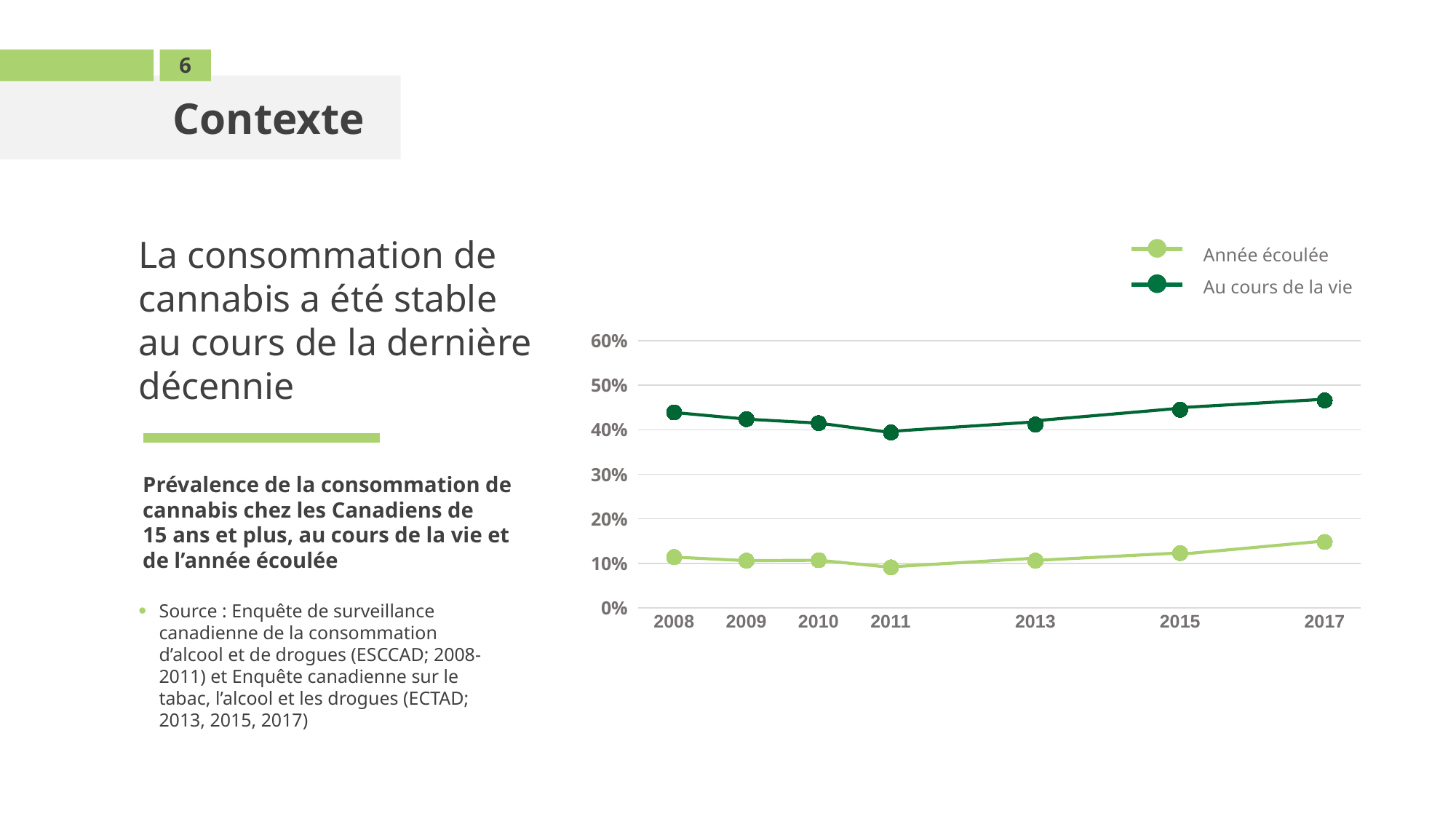
In which year is the 'Au cours de la vie' series at its highest? 2017 In which year is the 'Année écoulée' series at its highest? 2017 How many series does the legend list? 2 In which year is the 'Au cours de la vie' series at its lowest? 2011 In which year is the 'Année écoulée' series at its lowest? 2011 How many years are plotted along the x axis? 7 Does the 'Au cours de la vie' series rise or fall from 2011 to 2017? rise Which is larger for the 'Au cours de la vie' series: the value in 2017 or the value in 2011? 2017 Is the 'Année écoulée' value for 2017 greater or less than 20%? less What kind of chart is shown on the slide? Line chart